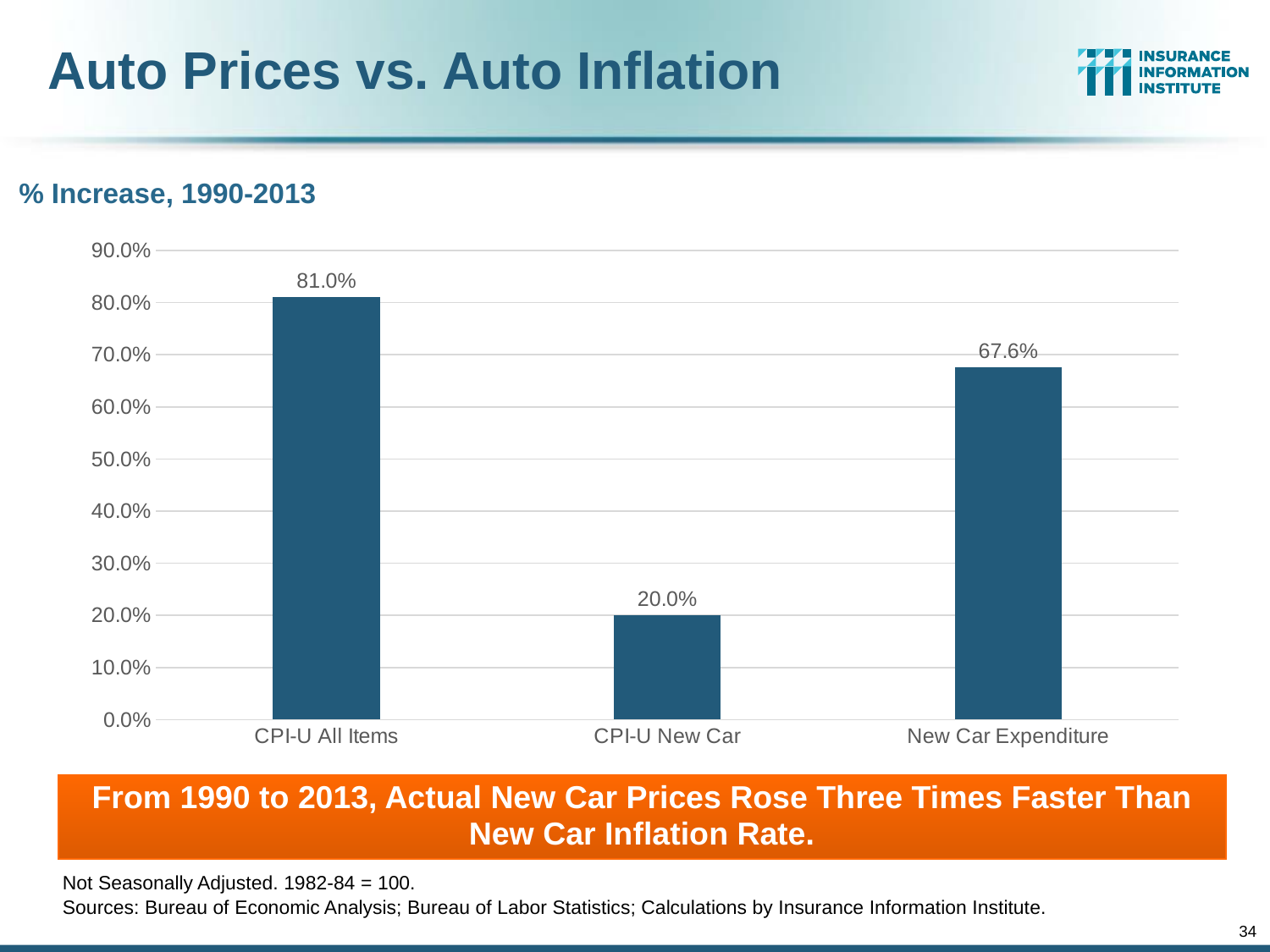
What is the difference between the % increase for CPI-U All Items and New Car Expenditure? 13.4% What is the % increase for New Car Expenditure? 67.6% What kind of chart is shown on the slide? Bar chart What is the % increase for CPI-U New Car? 20.0% Which category has the highest % increase? CPI-U All Items Which category has the lowest % increase? CPI-U New Car What is the title of the chart? % Increase, 1990-2013 What is the % increase for CPI-U All Items? 81.0% Is the value for New Car Expenditure greater or less than 60.0%? greater How many categories are shown in the chart? 3 Which is larger, the % increase for New Car Expenditure or for CPI-U New Car? New Car Expenditure What is the difference between the % increase for CPI-U All Items and CPI-U New Car? 61.0%